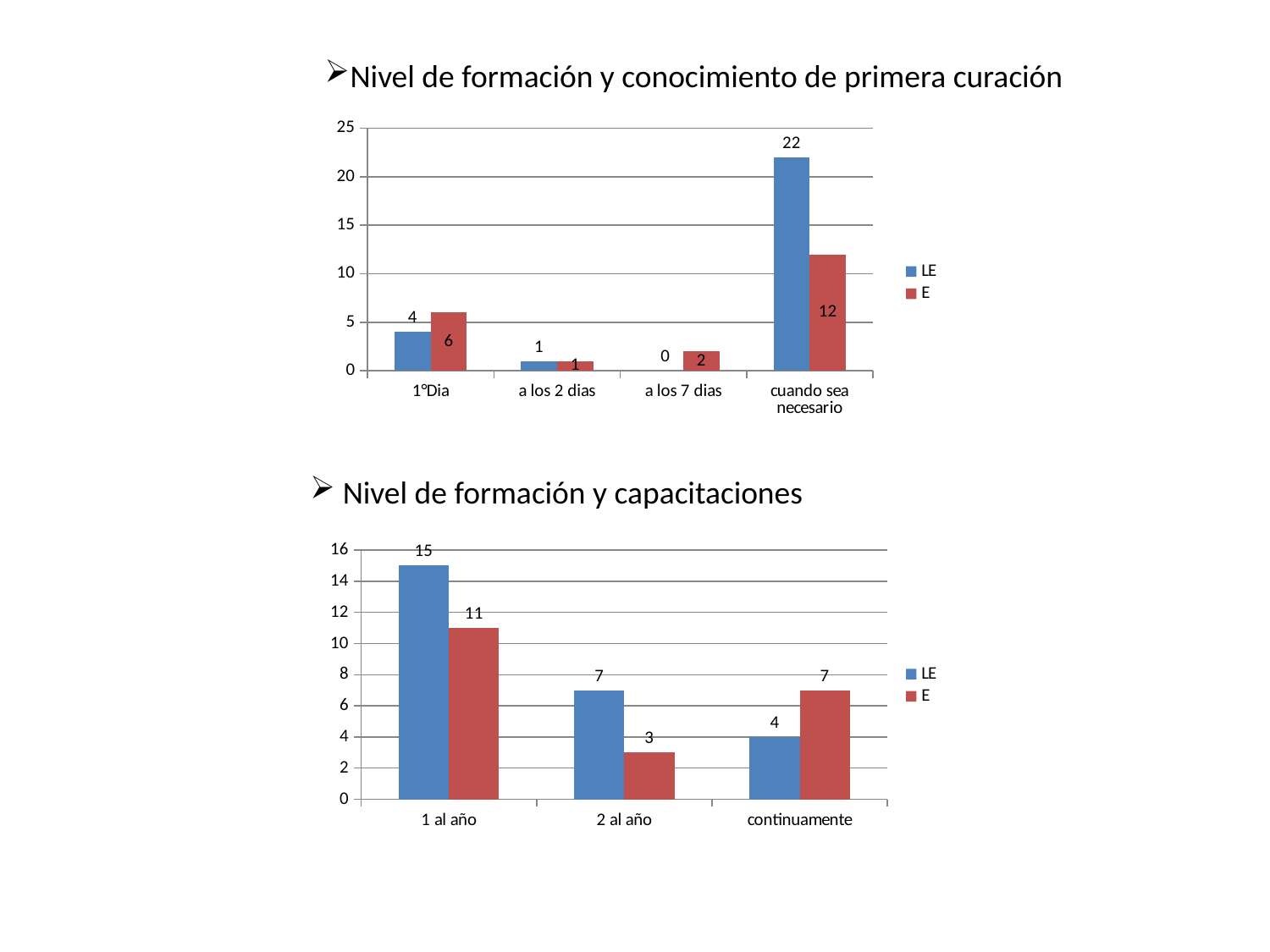
In the top chart (Nivel de formación y conocimiento de primera curación), how many categories are shown on the x axis? 4 In the bottom chart (Nivel de formación y capacitaciones), what is the LE value for '1 al año'? 15 In the top chart (Nivel de formación y conocimiento de primera curación), which category has the highest LE value? cuando sea necesario In the bottom chart (Nivel de formación y capacitaciones), which is larger for 'continuamente', LE or E? E What kind of chart is the bottom chart (Nivel de formación y capacitaciones)? Bar chart In the top chart (Nivel de formación y conocimiento de primera curación), what is the difference between the LE and E values for 'cuando sea necesario'? 10 In the bottom chart (Nivel de formación y capacitaciones), what is the difference between the LE and E values for '1 al año'? 4 In the top chart (Nivel de formación y conocimiento de primera curación), what is the LE value for 'a los 7 dias'? 0 In the bottom chart (Nivel de formación y capacitaciones), how many series does the legend list? 2 In the bottom chart (Nivel de formación y capacitaciones), what is the E value for '2 al año'? 3 In the top chart (Nivel de formación y conocimiento de primera curación), what is the E value for '1°Dia'? 6 In the top chart (Nivel de formación y conocimiento de primera curación), what is the LE value for 'cuando sea necesario'? 22